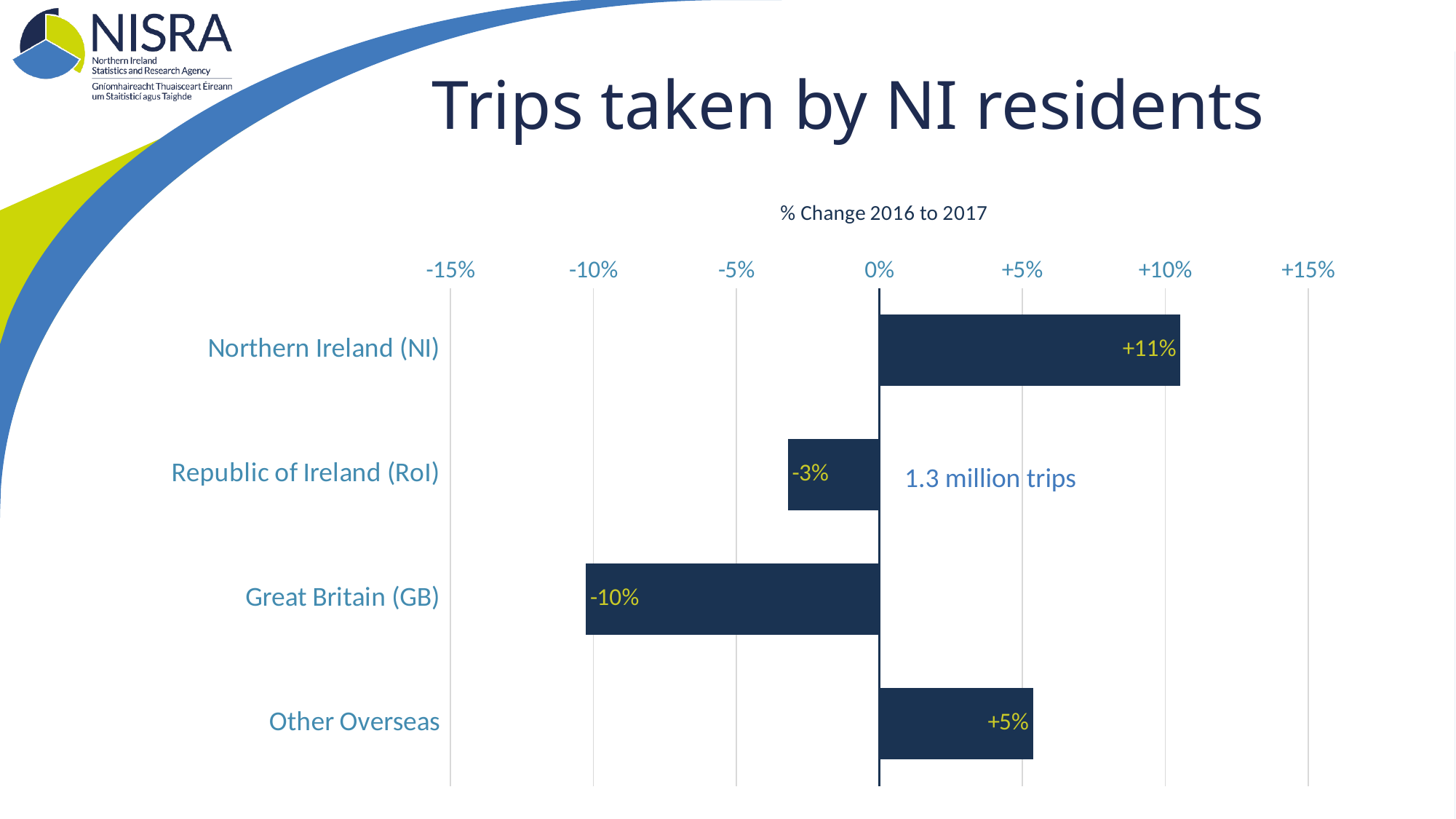
Which destination has the lowest % change 2016 to 2017? Great Britain (GB) What is the % change 2016 to 2017 for Great Britain (GB)? -10% What is the title of the chart's axis/subtitle shown above the bars? % Change 2016 to 2017 What is the difference in percentage points between the % change for Northern Ireland (NI) and Other Overseas? 6 percentage points What is the % change 2016 to 2017 for Northern Ireland (NI)? +11% How many destination categories are shown in the chart? 4 Which has a larger % change 2016 to 2017, Republic of Ireland (RoI) or Other Overseas? Other Overseas What annotation is shown next to the Republic of Ireland (RoI) bar? 1.3 million trips What type of chart is shown on the slide? Bar chart What is the % change 2016 to 2017 for Other Overseas? +5% What is the % change 2016 to 2017 for Republic of Ireland (RoI)? -3% Which destination has the highest % change 2016 to 2017? Northern Ireland (NI)